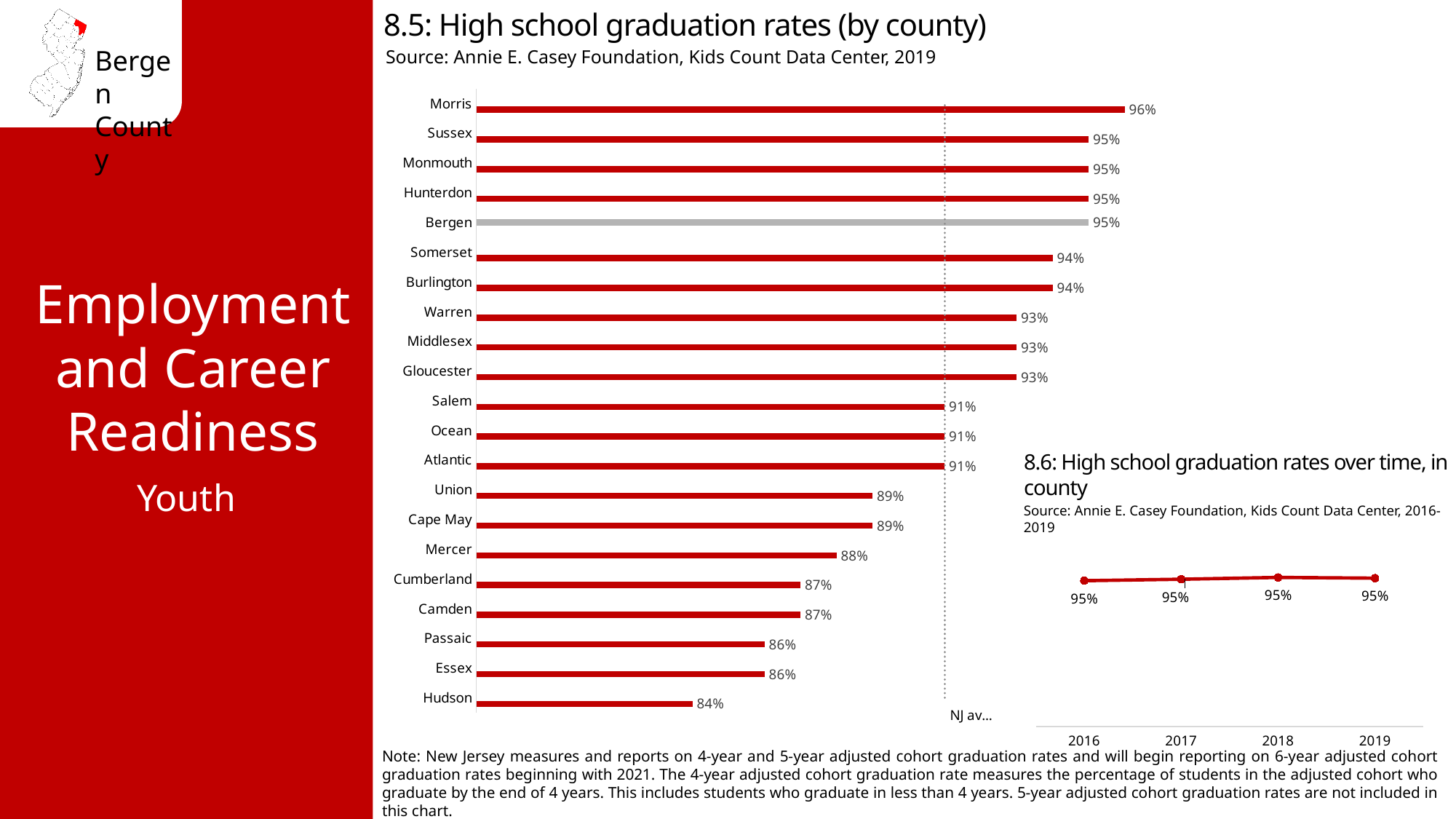
In the chart '8.5: High school graduation rates (by county)', what is the difference between the graduation rates of Morris and Hudson? 12 percentage points In the chart '8.5: High school graduation rates (by county)', what is the graduation rate for Hudson? 84% In the chart '8.5: High school graduation rates (by county)', how many counties are shown? 21 In the chart '8.6: High school graduation rates over time, in county', how many years are plotted? 4 In the chart '8.5: High school graduation rates (by county)', which county has a higher graduation rate, Mercer or Passaic? Mercer In the chart '8.5: High school graduation rates (by county)', what is the graduation rate for Somerset? 94% In the chart '8.5: High school graduation rates (by county)', which county's bar is shown in grey rather than red? Bergen In the chart '8.6: High school graduation rates over time, in county', what is the graduation rate for 2019? 95% What kind of chart is '8.5: High school graduation rates (by county)'? Bar chart In the chart '8.5: High school graduation rates (by county)', which county has the lowest graduation rate? Hudson In the chart '8.5: High school graduation rates (by county)', which county has the highest graduation rate? Morris In the chart '8.5: High school graduation rates (by county)', what is the graduation rate for Bergen? 95%